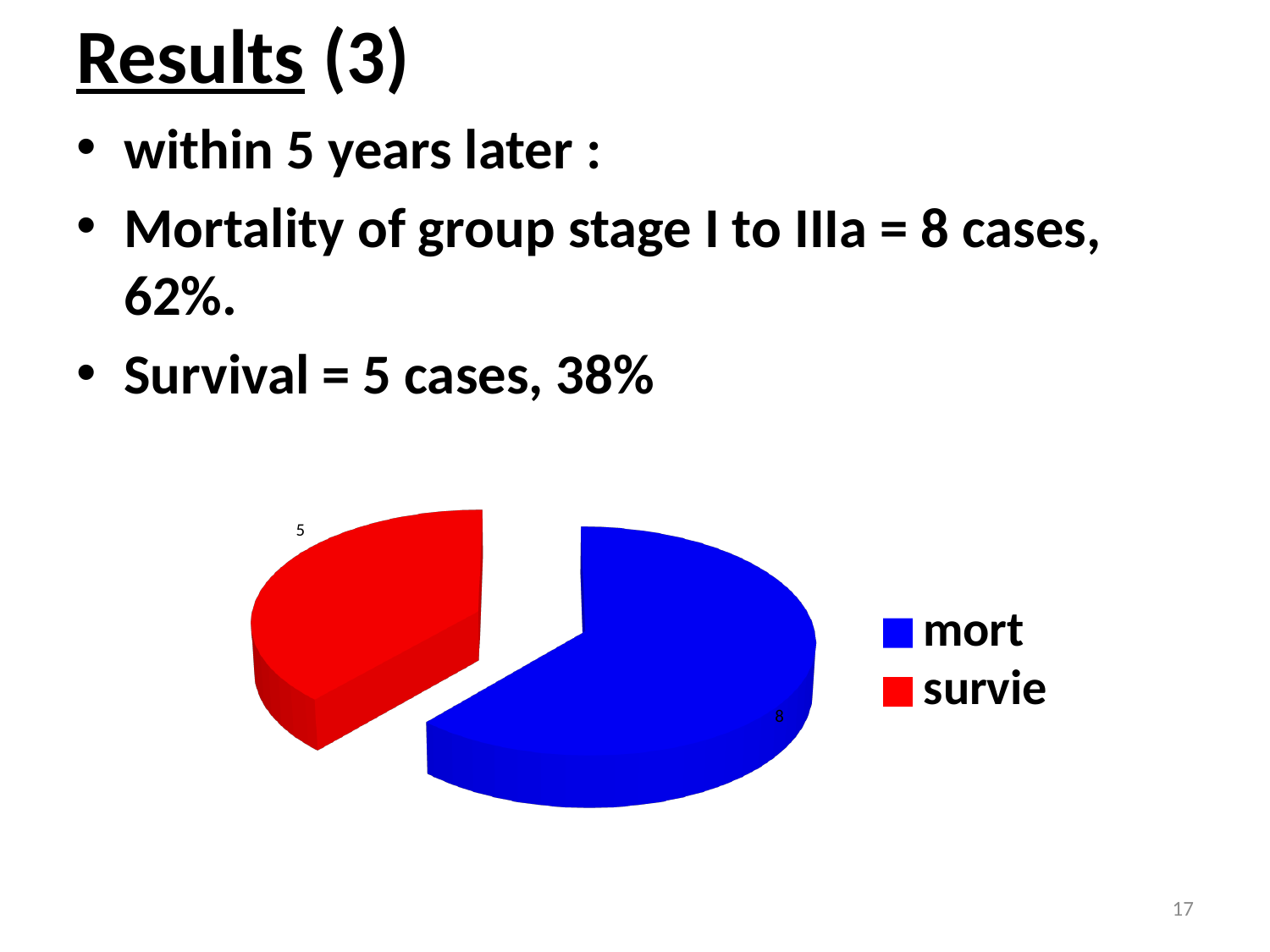
What colour is the 'survie' slice in the pie chart? red What is the difference between the 'mort' and 'survie' values in the pie chart? 3 Which is larger in the pie chart, 'mort' or 'survie'? mort Which slice of the pie chart is the largest? mort What is the total of all slices in the pie chart? 13 Which slice of the pie chart is the smallest? survie What share of the pie chart does the 'mort' slice represent? 62% How many slices does the pie chart have? 2 What is the value for the 'survie' slice in the pie chart? 5 What kind of chart is shown on the slide? pie chart How many entries does the legend of the pie chart list? 2 What is the value for the 'mort' slice in the pie chart? 8